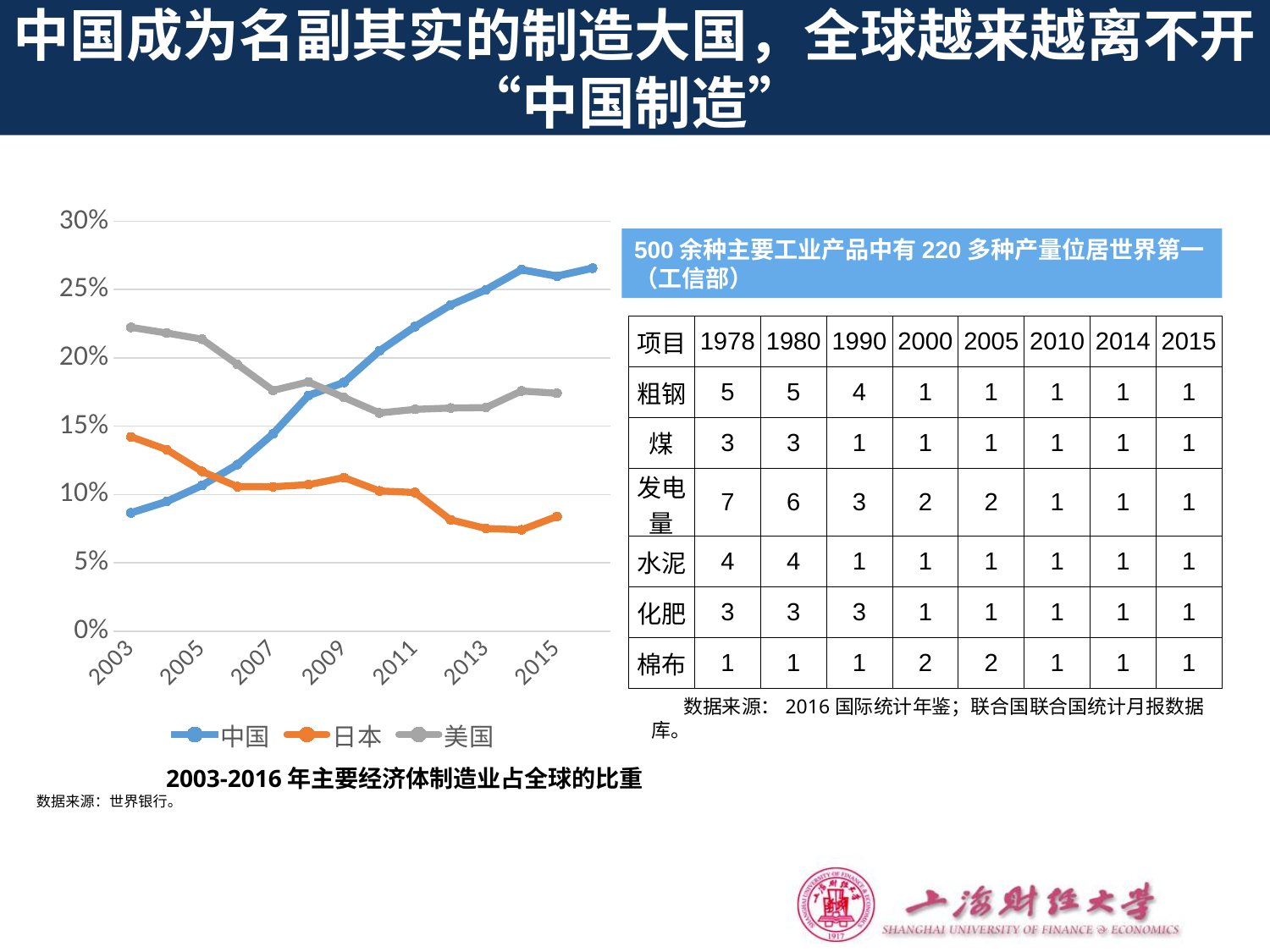
How many series does the legend of the line chart list? 3 In the line chart, which series has the highest value in 2015? 中国 What is the title of the line chart? 2003-2016 年主要经济体制造业占全球的比重 In the line chart, which series has the lowest value in 2015? 日本 Which series in the line chart is drawn in blue? 中国 In the line chart, is the value for 美国 in 2003 greater or less than 20%? greater In the line chart, is the value for 中国 in 2003 greater or less than 10%? less In the line chart, does the value for 日本 rise or fall from 2003 to 2016? fall In the line chart, does the value for 中国 rise or fall from 2003 to 2016? rise In the line chart, which series has the lowest value in 2003? 中国 In the line chart, which series has the highest value in 2003? 美国 What kind of chart is shown on the left of the slide? line chart